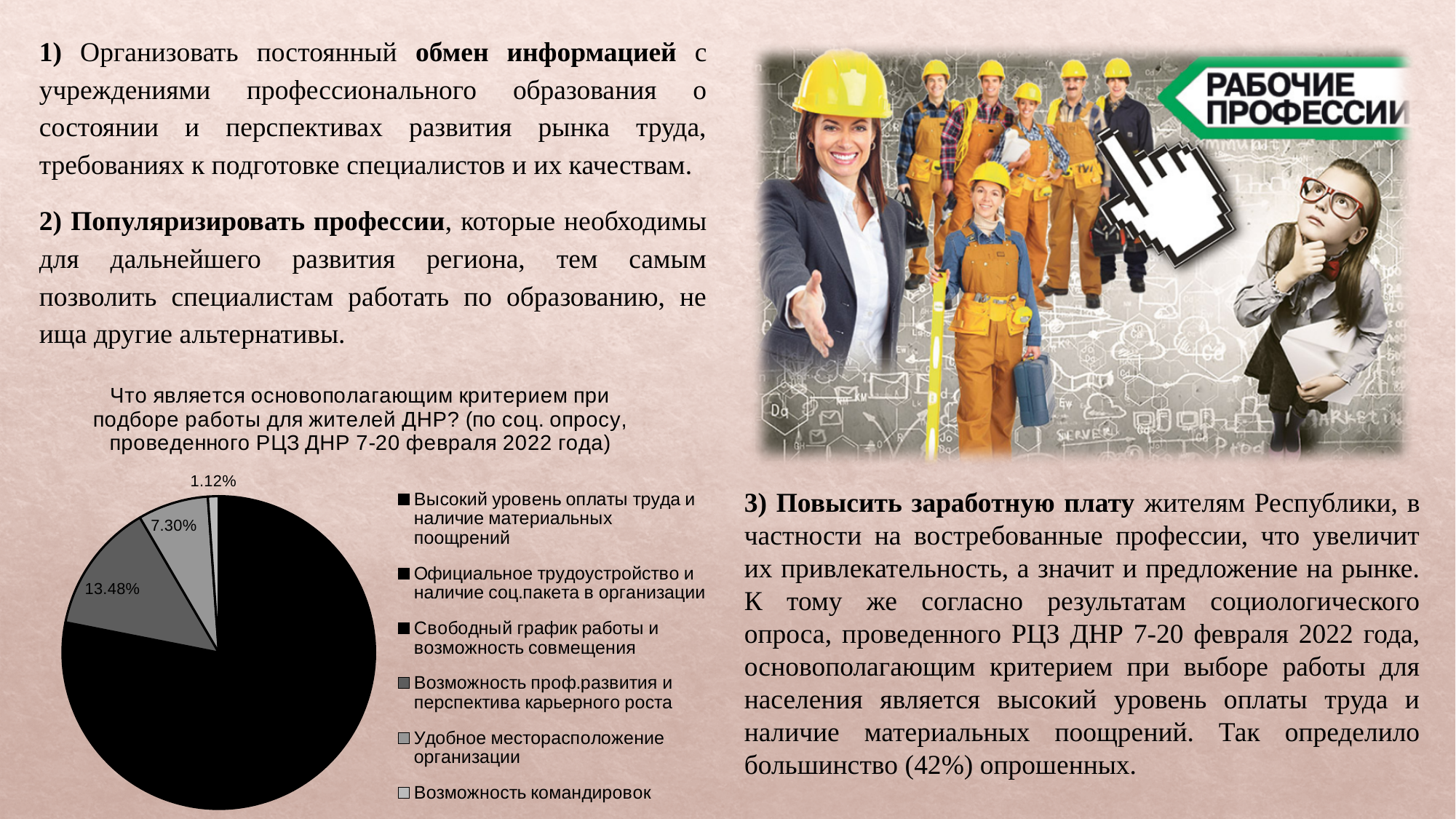
What share of the pie does the slice for 'Возможность командировок' have? 1.12% What is the largest percentage printed as a data label on the pie chart? 13.48% How many categories does the legend of the pie chart list? 6 During which dates was the survey referenced in the pie chart title conducted? 7-20 февраля 2022 года Does the black portion of the pie chart cover more or less than half of the pie? more What is the difference between the 13.48% slice and the 7.30% slice of the pie chart? 6.18% Which slice is larger on the pie chart: the one labelled 13.48% or the one labelled 7.30%? 13.48% What share of the pie does the slice for 'Возможность проф.развития и перспектива карьерного роста' have? 13.48% What is the smallest percentage printed on the pie chart? 1.12% What type of chart is shown on the slide? pie chart How many slices of the pie chart have a percentage label printed on them? 3 What is the first entry listed in the legend of the pie chart? Высокий уровень оплаты труда и наличие материальных поощрений